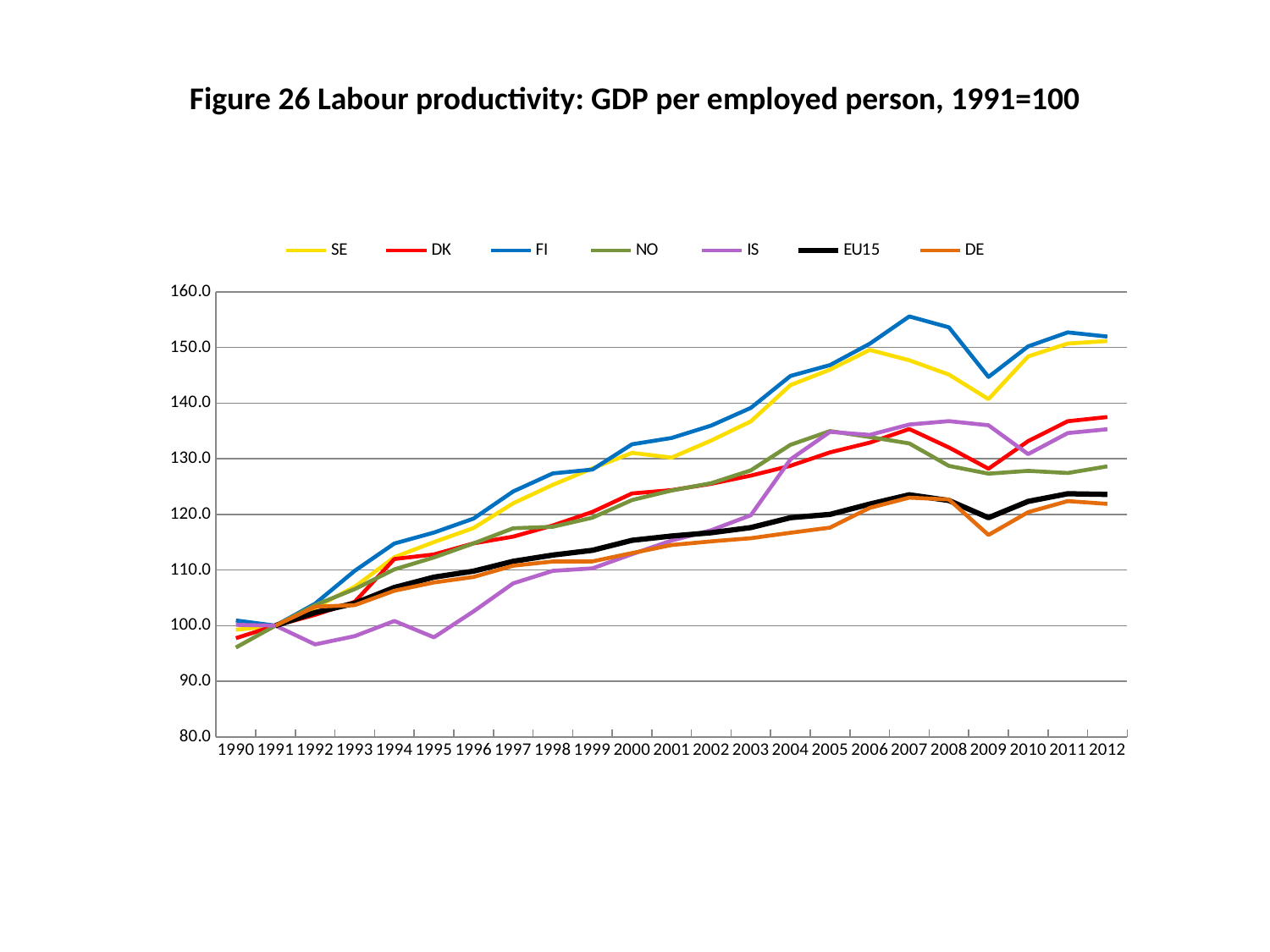
Which is larger in 1995, the value for IS or the value for DE? DE What kind of chart is shown on the slide? line chart What is the value for SE in 1991? 100.0 Is the value for FI in 2007 greater or less than 150? greater What colour is the EU15 line in the legend? black Does the FI series rise or fall between 1991 and 2007? rise Is the value for NO in 2012 greater or less than 130? less Is the value for DE in 2009 greater or less than 120? less Which series has the highest value in 2007? FI How many years are plotted along the x axis? 23 How many series does the legend list? 7 Which series has the lowest value in 1992? IS